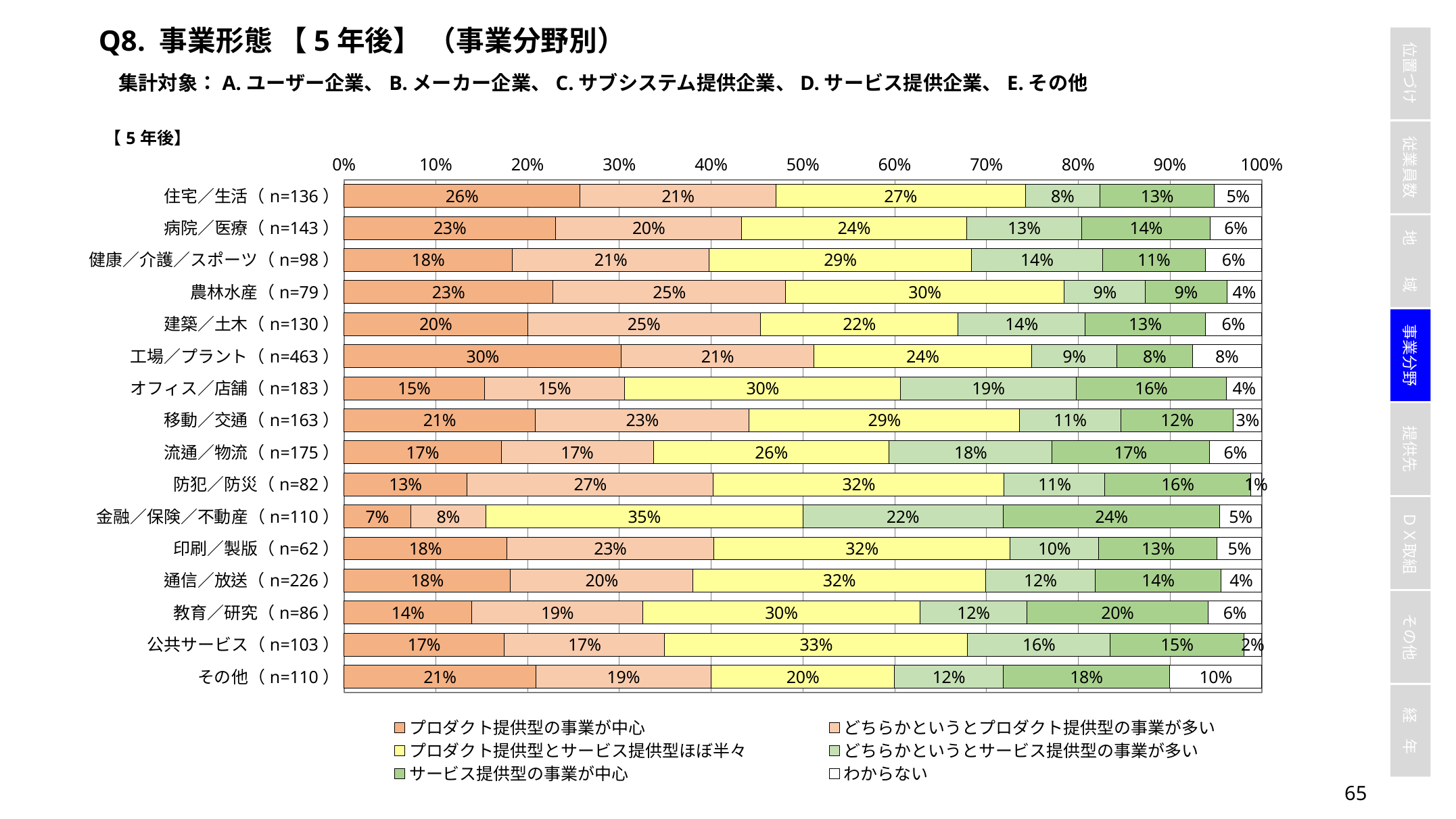
What is the value of サービス提供型の事業が中心 for 金融／保険／不動産 (n=110)? 24% What kind of chart is shown on the slide? Stacked bar chart Which has the larger value for サービス提供型の事業が中心: 教育／研究 or 流通／物流? 教育／研究 What colour does the legend use for わからない? White How many business-field categories (rows) are plotted in the chart? 16 Which category has the lowest value for プロダクト提供型の事業が中心? 金融／保険／不動産 (n=110) What is the difference between the プロダクト提供型の事業が中心 values for 住宅／生活 (26%) and 金融／保険／不動産 (7%)? 19 percentage points What is the value of プロダクト提供型とサービス提供型ほぼ半々 for 公共サービス (n=103)? 33% How many series does the legend list? 6 What is the value of プロダクト提供型の事業が中心 for 工場／プラント (n=463)? 30% What is the value of わからない for その他 (n=110)? 10% Which category has the highest value for プロダクト提供型の事業が中心? 工場／プラント (n=463)